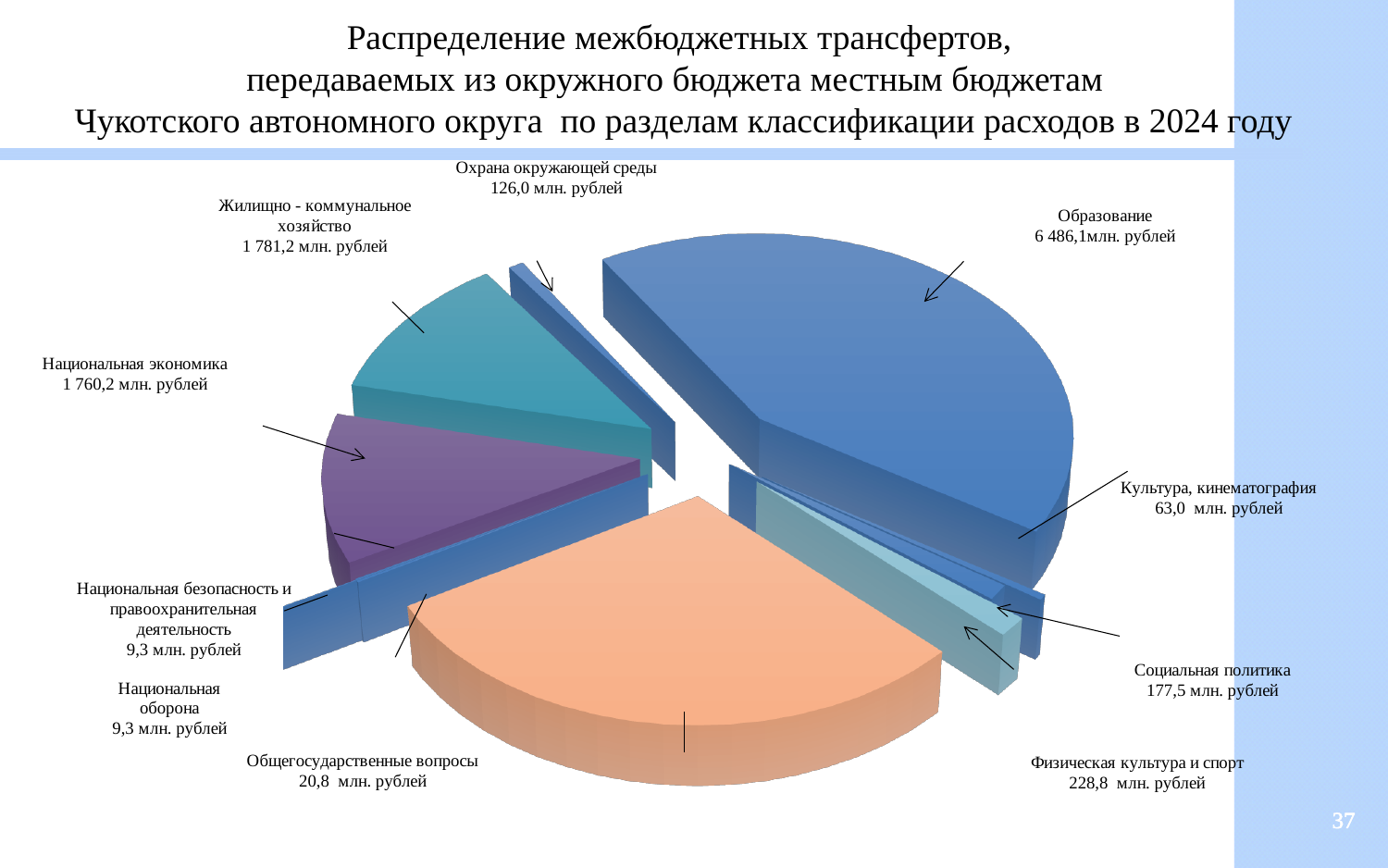
What is the value for Жилищно-коммунальное хозяйство? 1 781,2 млн. рублей What is the difference between Жилищно-коммунальное хозяйство and Национальная экономика? 21,0 млн. рублей Which category has the highest value? Образование What is the value for Социальная политика? 177,5 млн. рублей What is the value for Национальная экономика? 1 760,2 млн. рублей Which is larger, Социальная политика or Охрана окружающей среды? Социальная политика What is the value for Образование? 6 486,1 млн. рублей What kind of chart is shown on the slide? Pie chart What is the value for Охрана окружающей среды? 126,0 млн. рублей What is the value for Физическая культура и спорт? 228,8 млн. рублей What is the difference between Физическая культура и спорт and Социальная политика? 51,3 млн. рублей